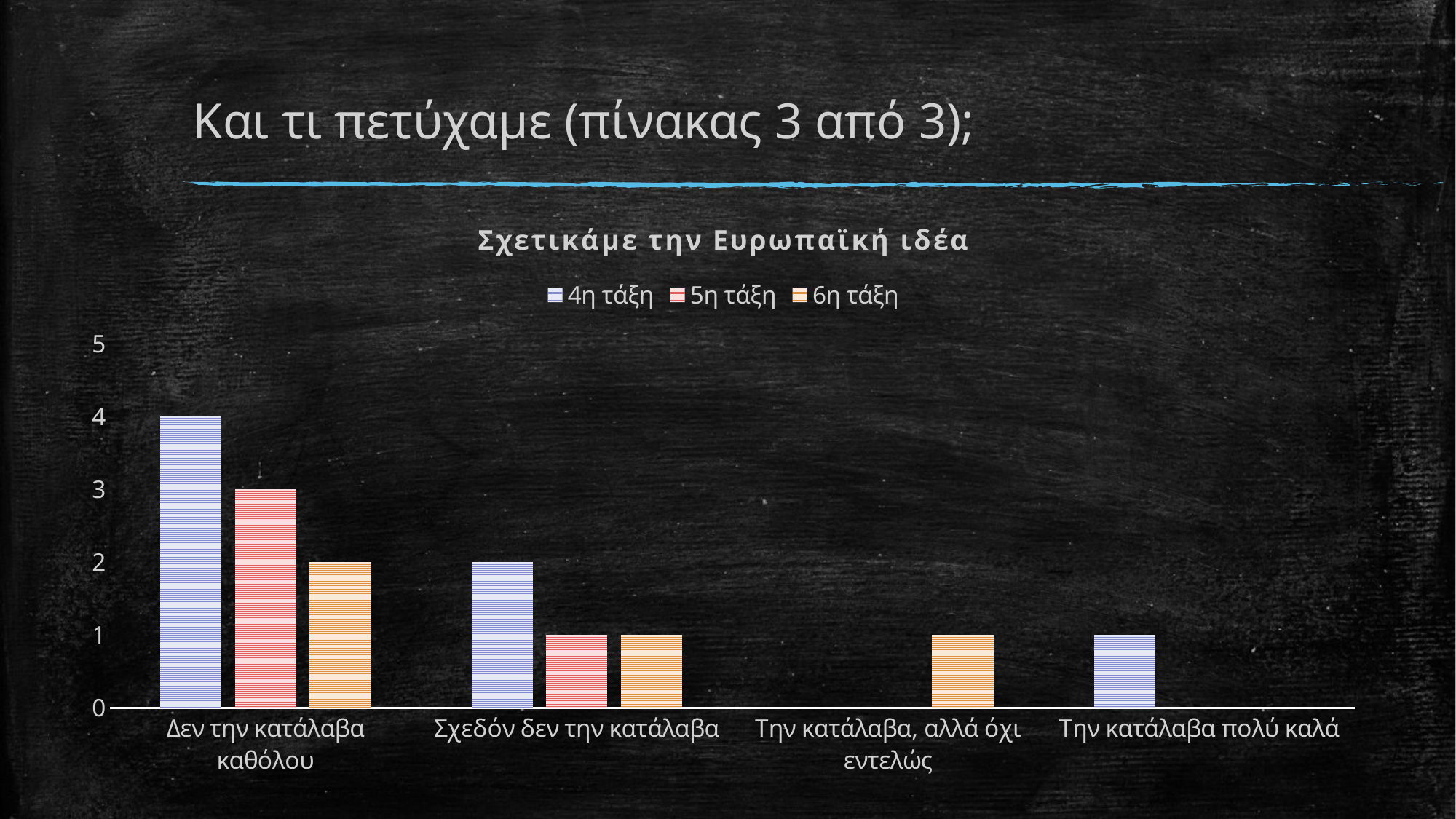
What is the difference between the 4η τάξη and 6η τάξη values in the category 'Δεν την κατάλαβα καθόλου'? 2 What is the title of the chart? Σχετικάμε την Ευρωπαϊκή ιδέα What kind of chart is shown on the slide? bar chart How many categories are shown on the x axis? 4 Which series has a bar in the category 'Την κατάλαβα, αλλά όχι εντελώς'? 6η τάξη How many series does the legend list? 3 Which series has the highest value in the category 'Δεν την κατάλαβα καθόλου'? 4η τάξη Which series has the lowest value in the category 'Δεν την κατάλαβα καθόλου'? 6η τάξη What is the value for 6η τάξη in the category 'Σχεδόν δεν την κατάλαβα'? 1 What is the value for 4η τάξη in the category 'Δεν την κατάλαβα καθόλου'? 4 What is the value for 5η τάξη in the category 'Δεν την κατάλαβα καθόλου'? 3 Which is larger: the 4η τάξη value for 'Σχεδόν δεν την κατάλαβα' or the 4η τάξη value for 'Την κατάλαβα πολύ καλά'? Σχεδόν δεν την κατάλαβα